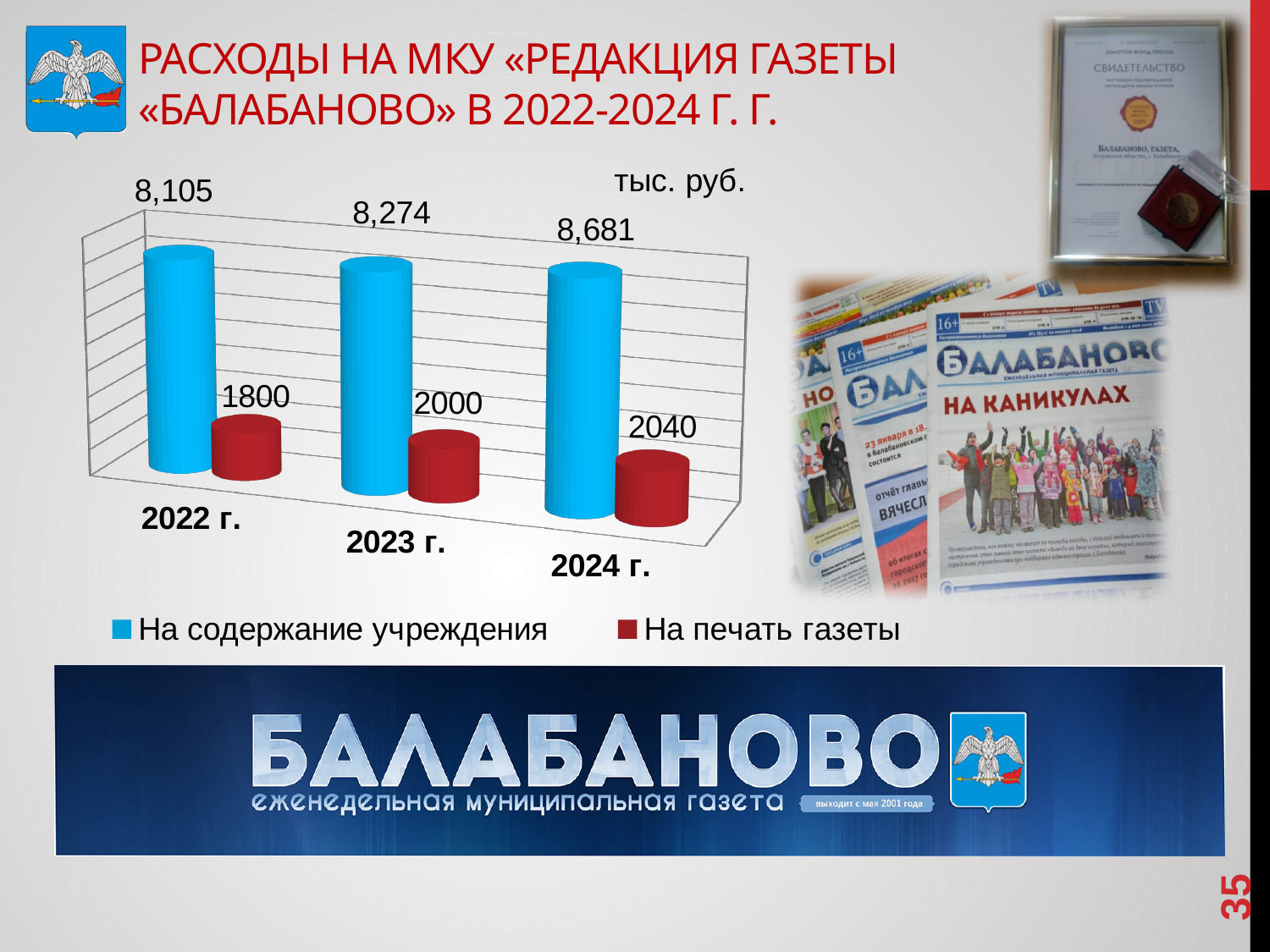
Which is larger in 2023 г.: «На содержание учреждения» or «На печать газеты»? На содержание учреждения What is the difference between «На печать газеты» in 2023 г. and 2022 г.? 200 How many years are shown on the chart? 3 Do the values for «На содержание учреждения» rise or fall from 2022 г. to 2024 г.? rise What is the value for «На содержание учреждения» in 2024 г.? 8,681 How many series does the legend list? 2 What is the value for «На содержание учреждения» in 2022 г.? 8,105 What is the value for «На печать газеты» in 2023 г.? 2000 In which year is «На содержание учреждения» highest? 2024 г. What is the value for «На печать газеты» in 2024 г.? 2040 By how much did «На содержание учреждения» increase from 2023 г. to 2024 г.? 407 In which year is «На печать газеты» lowest? 2022 г.